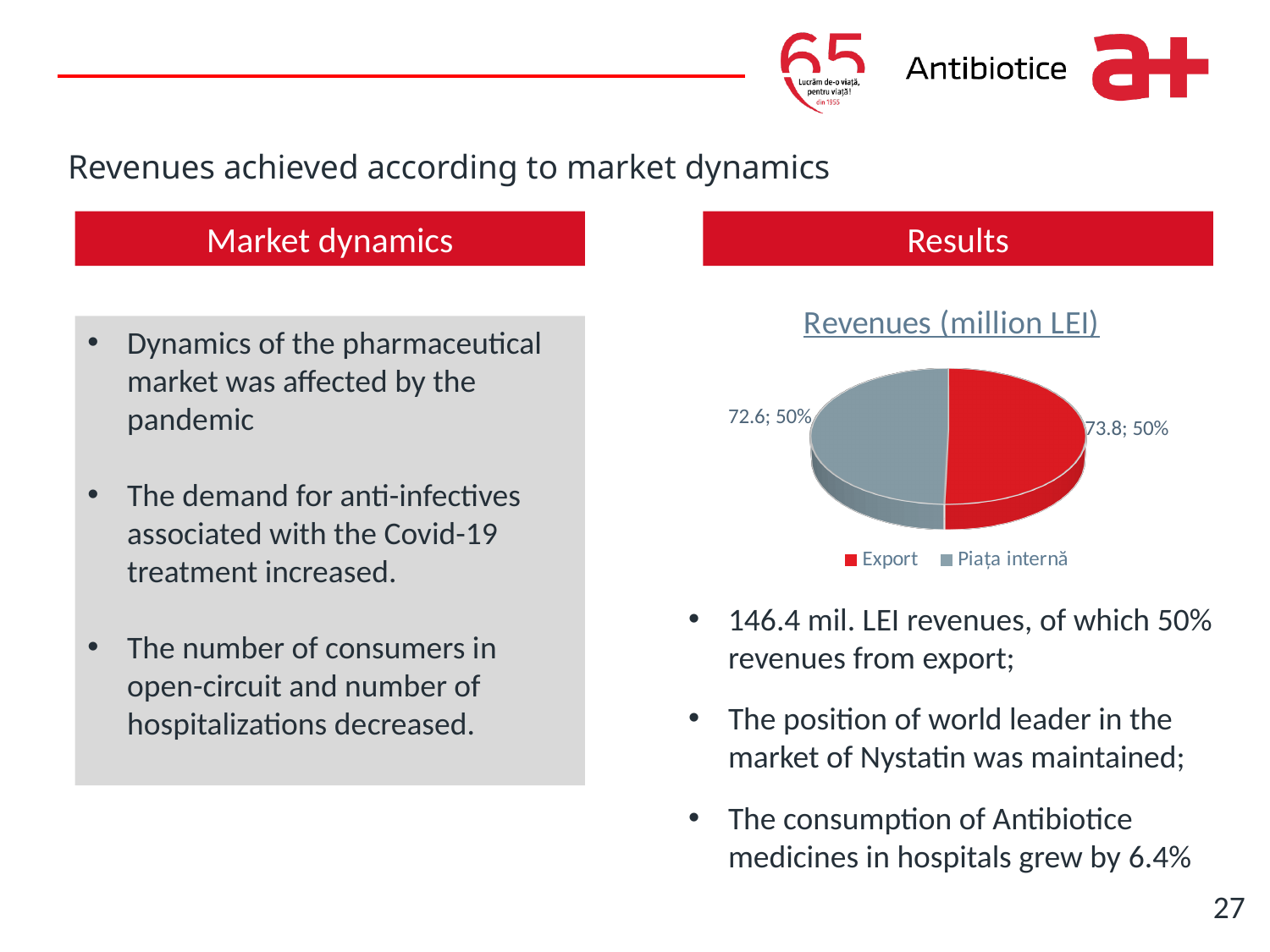
What is the title of the pie chart on the slide? Revenues (million LEI) What kind of chart is used to show Revenues (million LEI)? Pie chart What is the value for Piața internă in the Revenues (million LEI) pie chart? 72.6 How many entries does the legend of the Revenues (million LEI) chart list? 2 What share of the Revenues (million LEI) pie does Piața internă represent? 50% How many slices does the Revenues (million LEI) pie chart have? 2 What is the value for Export in the Revenues (million LEI) pie chart? 73.8 What is the total of the two values shown in the Revenues (million LEI) pie chart? 146.4 What share of the Revenues (million LEI) pie does Export represent? 50% Which slice has the larger value in the Revenues (million LEI) chart, Export or Piața internă? Export Which colour represents Export in the Revenues (million LEI) pie chart? Red What is the difference between the Export value and the Piața internă value in the Revenues (million LEI) chart? 1.2